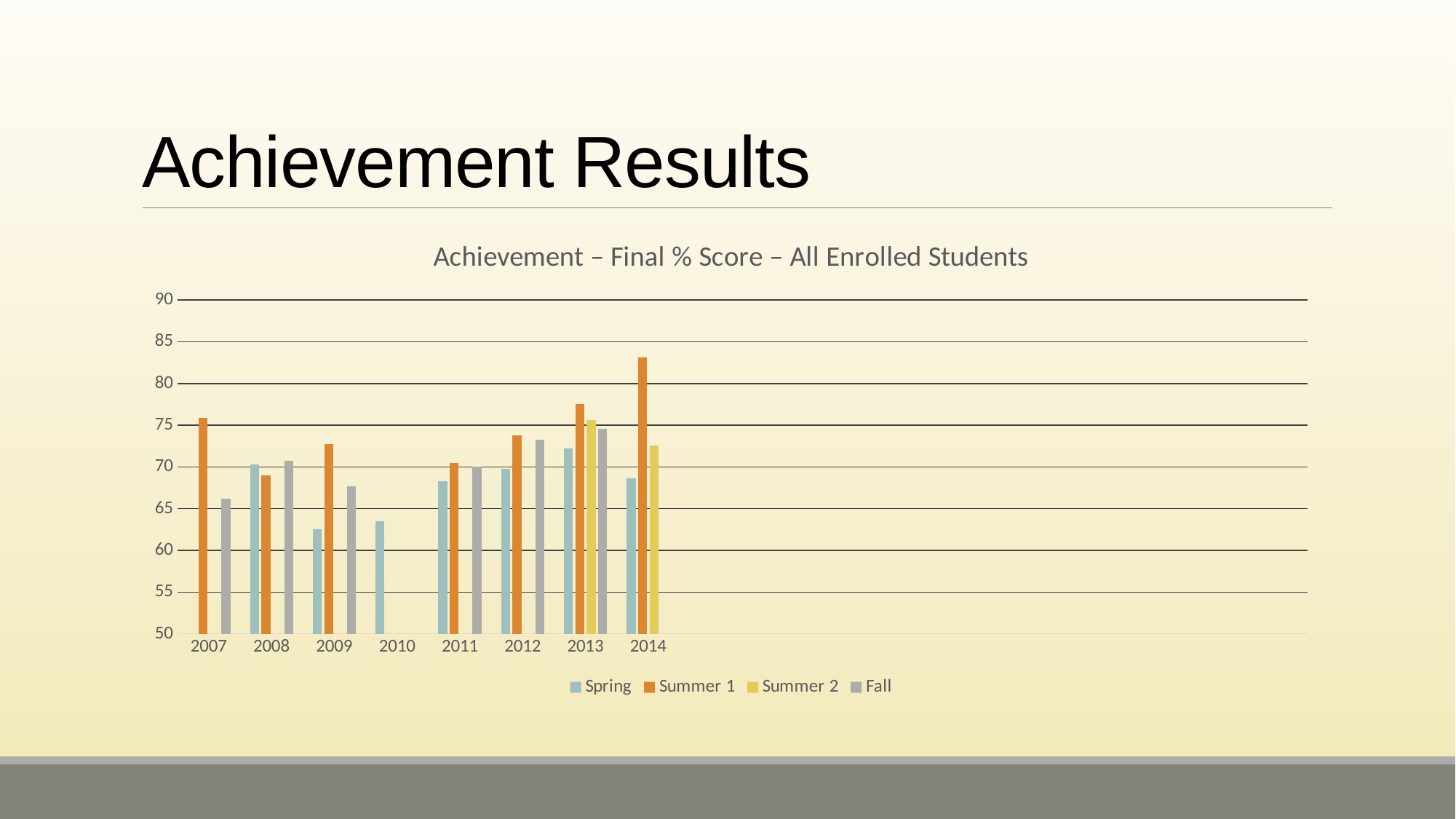
How many years are shown on the x axis? 8 In 2013, which is larger: the Summer 1 value or the Summer 2 value? Summer 1 Is the Spring value for 2009 greater or less than 65? less Is the Spring value for 2010 greater or less than 65? less In which year is the Fall bar the lowest? 2007 In 2007, which is larger: the Summer 1 value or the Fall value? Summer 1 Is the Summer 1 value for 2014 greater or less than 80? greater Do the Summer 1 values rise or fall from 2011 to 2014? rise What is the title of the chart? Achievement – Final % Score – All Enrolled Students What kind of chart is shown on the slide? Bar chart In which year is the Summer 1 bar the highest? 2014 How many series does the legend list? 4